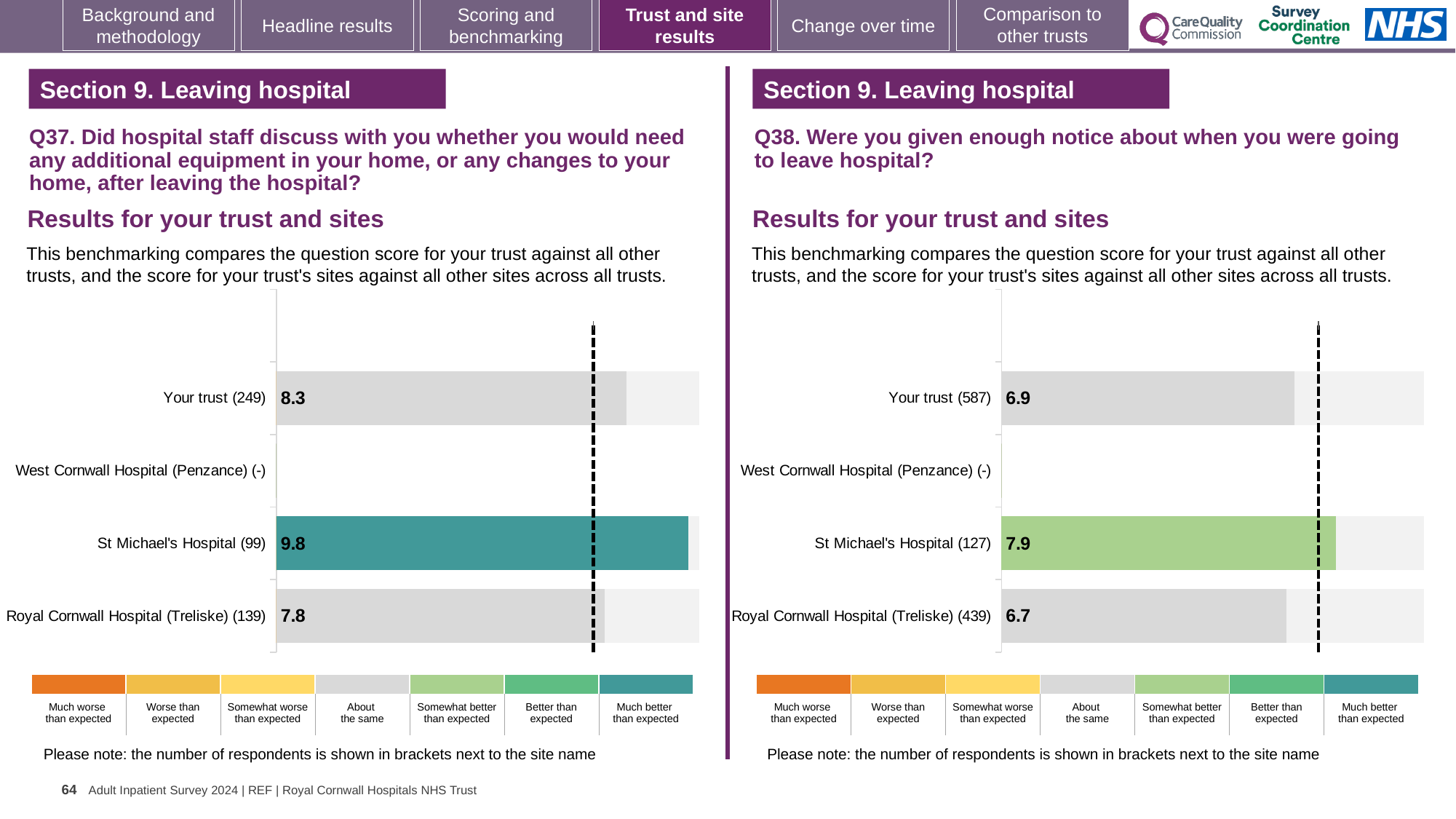
In the Q37 chart on the left, which site has the highest score? St Michael's Hospital In the Q37 chart on the left, what is the score for St Michael's Hospital? 9.8 In the Q37 chart on the left, what is the difference between the scores for St Michael's Hospital and Royal Cornwall Hospital (Treliske)? 2.0 In the Q38 chart on the right, what is the score for Royal Cornwall Hospital (Treliske)? 6.7 What type of chart is used for the Q37 results on the left? Bar chart In the Q38 chart on the right, what is the difference between the scores for St Michael's Hospital and Your trust? 1.0 In the Q38 chart on the right, which benchmark category does the colour of the St Michael's Hospital bar correspond to? Somewhat better than expected In the Q37 chart on the left, how many respondents are shown in brackets for St Michael's Hospital? 99 In the Q38 chart on the right, what is the score for Your trust? 6.9 In the Q38 chart on the right, which has the larger score, Your trust or St Michael's Hospital? St Michael's Hospital In the Q38 chart on the right, which site or trust row has the lowest score? Royal Cornwall Hospital (Treliske) In the Q37 chart on the left, what is the score for Your trust? 8.3